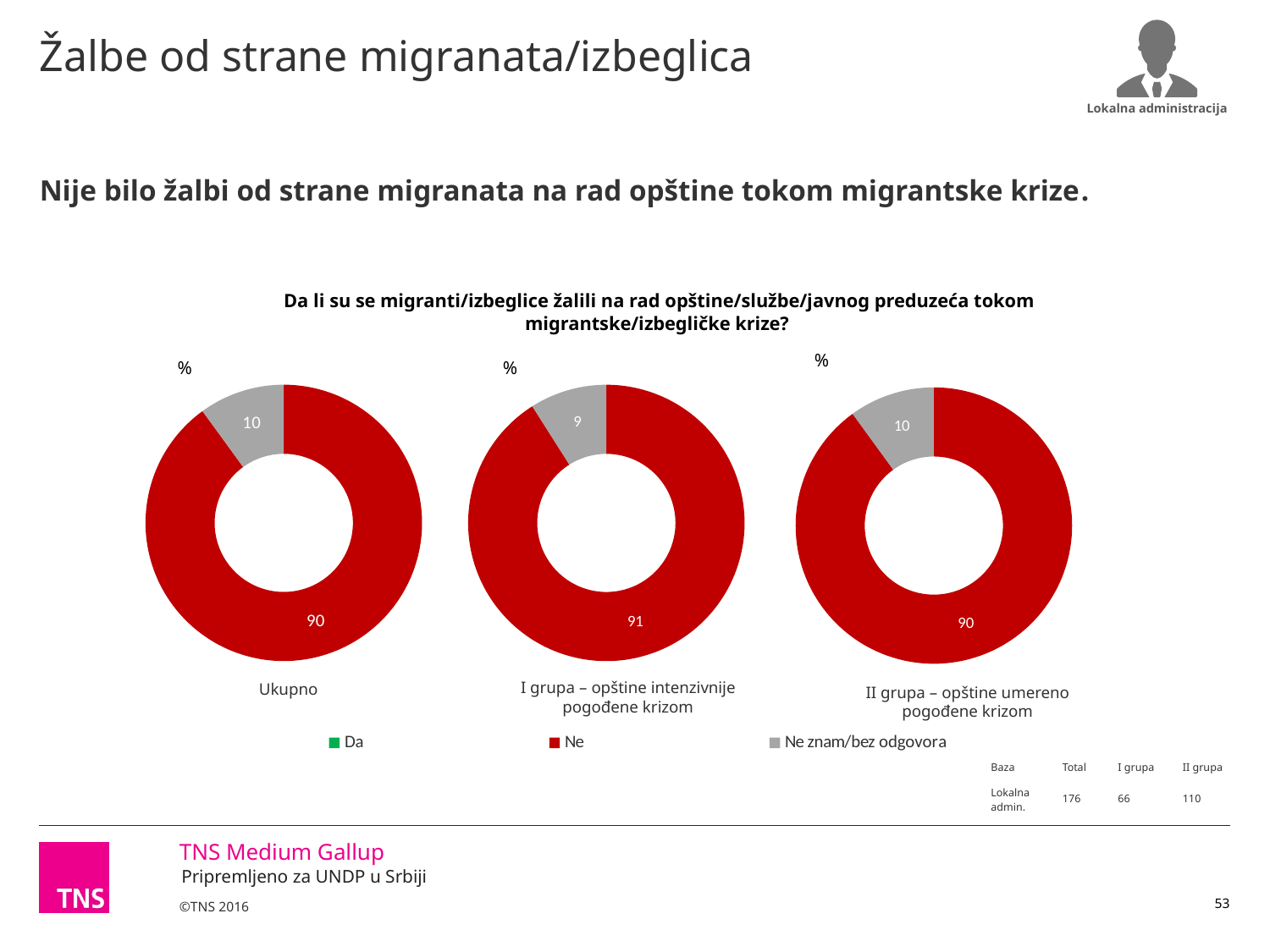
In the 'II grupa – opštine umereno pogođene krizom' chart, what is the value for 'Ne'? 90 In the 'Ukupno' chart, what is the value for 'Ne znam/bez odgovora'? 10 In the 'I grupa – opštine intenzivnije pogođene krizom' chart, what is the value for 'Ne znam/bez odgovora'? 9 In the 'I grupa – opštine intenzivnije pogođene krizom' chart, what is the difference between 'Ne' and 'Ne znam/bez odgovora'? 82 In the 'Ukupno' chart, which category has the largest share? Ne How many donut charts are shown on the slide? 3 What type of chart is used on this slide? Donut chart In the 'II grupa – opštine umereno pogođene krizom' chart, what is the value for 'Ne znam/bez odgovora'? 10 In the 'I grupa – opštine intenzivnije pogođene krizom' chart, what is the value for 'Ne'? 91 In the 'Ukupno' chart, what is the value for 'Ne'? 90 Is the value for 'Ne' larger in the 'I grupa' chart or in the 'II grupa' chart? I grupa How many series does the legend list? 3